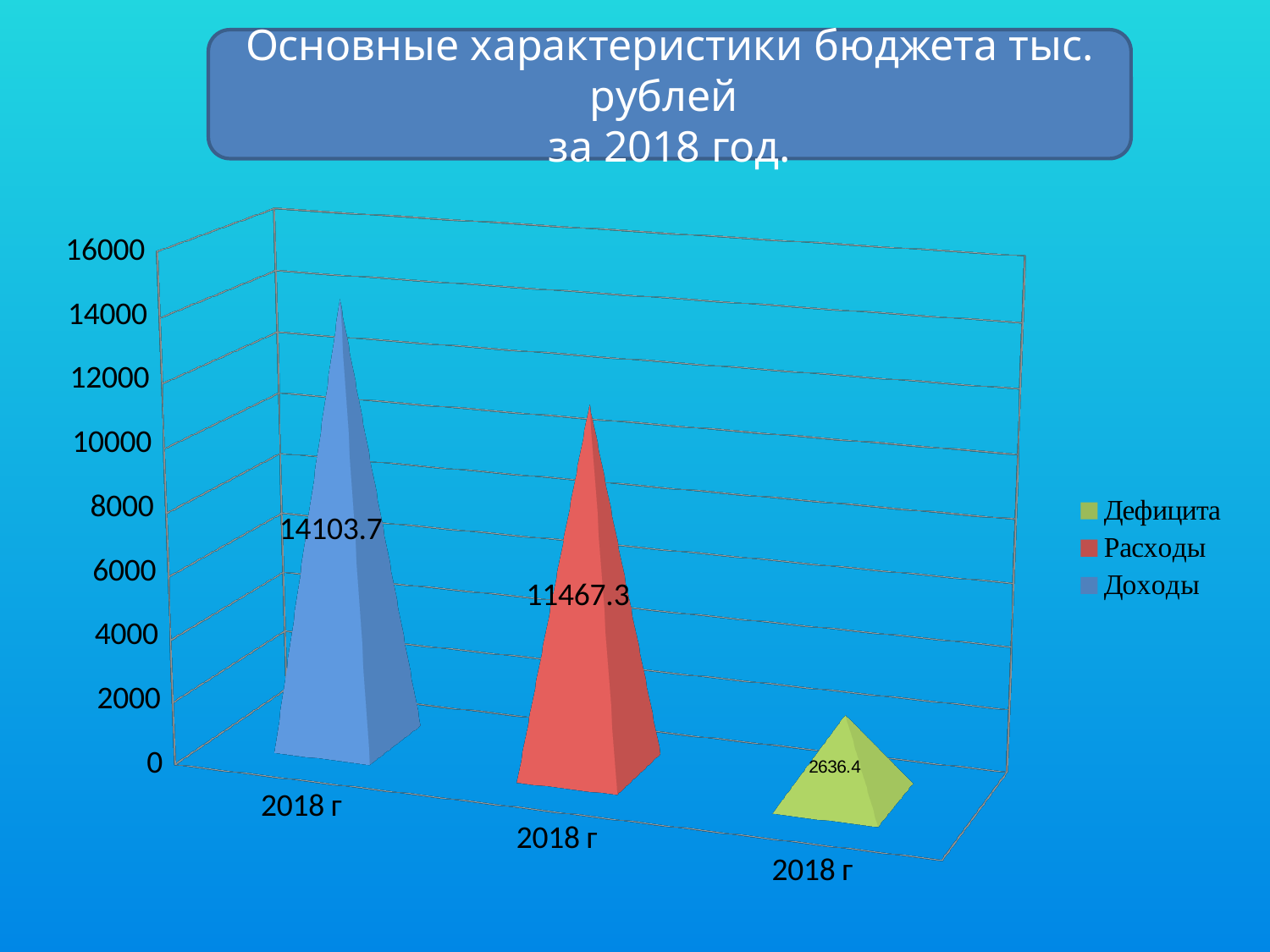
How many series does the legend list? 3 What colour represents Дефицита in the chart? green Which series has the highest value? Доходы Is the value for Расходы greater or less than 10000? greater What is the difference between Расходы and Дефицита? 8830.9 Which is larger, Расходы or Дефицита? Расходы Which series has the lowest value? Дефицита What kind of chart is shown on the slide? bar chart What is the difference between Доходы and Расходы? 2636.4 What is the value for Расходы? 11467.3 What is the value for Доходы? 14103.7 What is the value for Дефицита? 2636.4